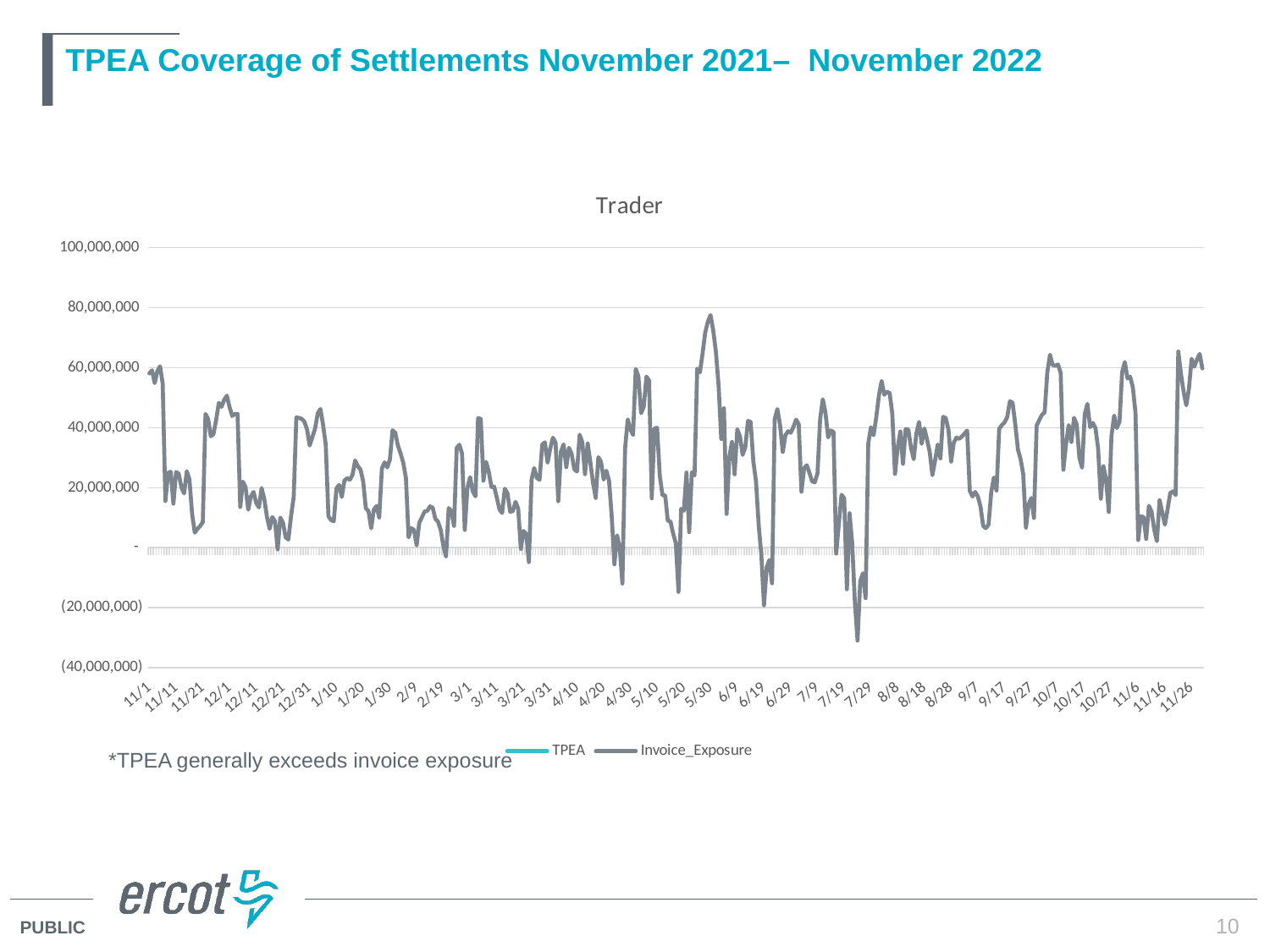
Is the Invoice_Exposure value at 11/26 greater or less than 40,000,000? greater Which two series are listed in the chart legend? TPEA and Invoice_Exposure Is the highest value of Invoice_Exposure greater or less than 60,000,000? greater Is the highest value of Invoice_Exposure greater or less than 80,000,000? less How many series does the legend of the chart list? 2 What is the title of the chart? Trader What is the highest value shown on the vertical axis of the chart? 100,000,000 What kind of chart is shown on the slide? Line chart What is the lowest value shown on the vertical axis of the chart? (40,000,000)